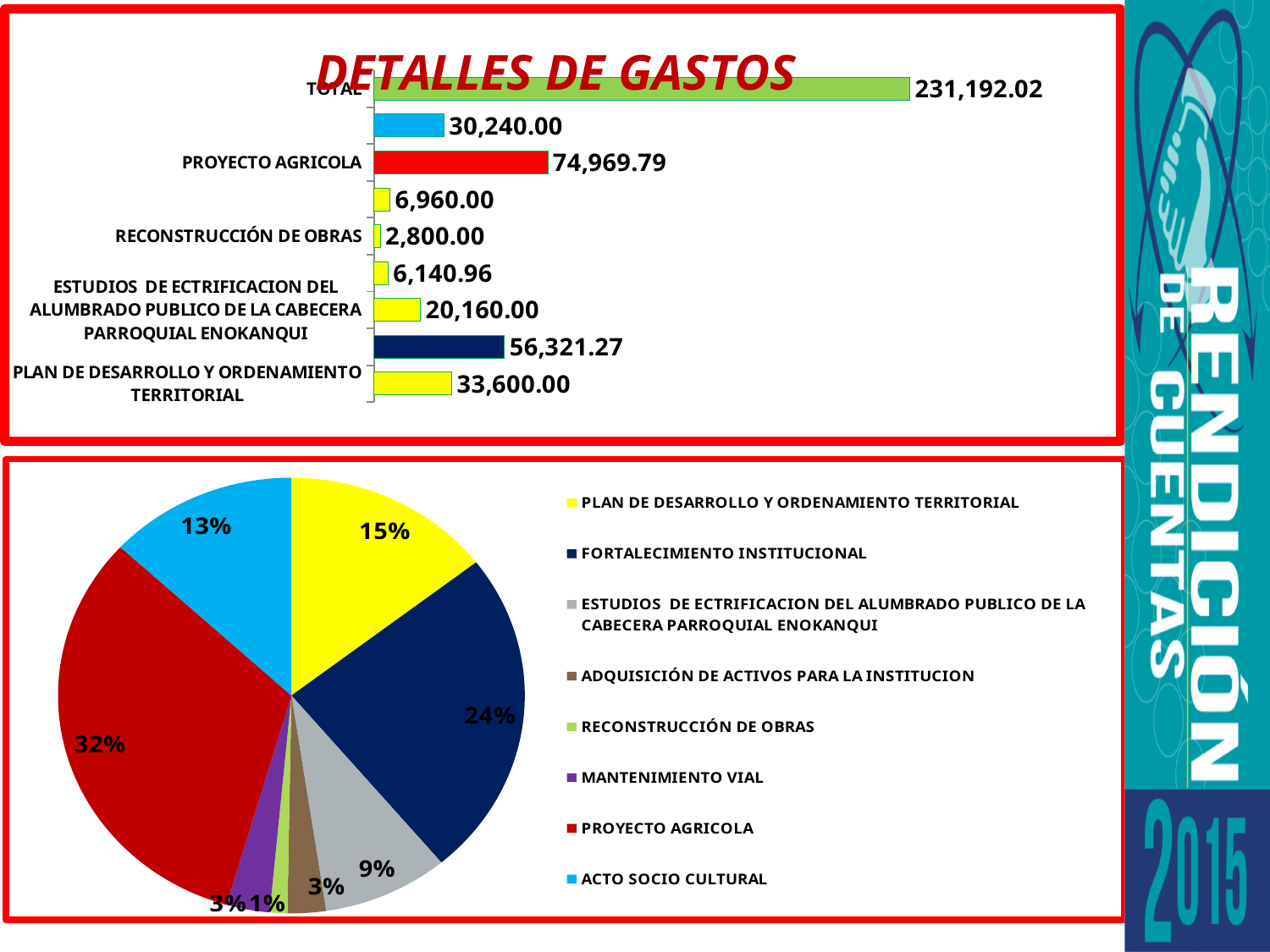
In the pie chart at the bottom of the slide, what share does FORTALECIMIENTO INSTITUCIONAL have? 24% In the pie chart at the bottom of the slide, which category has the largest slice? PROYECTO AGRICOLA In the bar chart titled DETALLES DE GASTOS, which is larger, the value for PROYECTO AGRICOLA or the value for RECONSTRUCCIÓN DE OBRAS? PROYECTO AGRICOLA In the pie chart at the bottom of the slide, what share does PROYECTO AGRICOLA have? 32% What kind of chart is the top chart titled DETALLES DE GASTOS? bar chart In the bar chart titled DETALLES DE GASTOS, what is the value for RECONSTRUCCIÓN DE OBRAS? 2,800.00 How many categories does the legend of the pie chart at the bottom of the slide list? 8 In the pie chart at the bottom of the slide, which category has the smallest slice? RECONSTRUCCIÓN DE OBRAS In the bar chart titled DETALLES DE GASTOS, what is the difference between the values for PROYECTO AGRICOLA and PLAN DE DESARROLLO Y ORDENAMIENTO TERRITORIAL? 41,369.79 In the bar chart titled DETALLES DE GASTOS, what is the value for PLAN DE DESARROLLO Y ORDENAMIENTO TERRITORIAL? 33,600.00 In the bar chart titled DETALLES DE GASTOS, what is the value for TOTAL? 231,192.02 In the bar chart titled DETALLES DE GASTOS, what is the value for PROYECTO AGRICOLA? 74,969.79